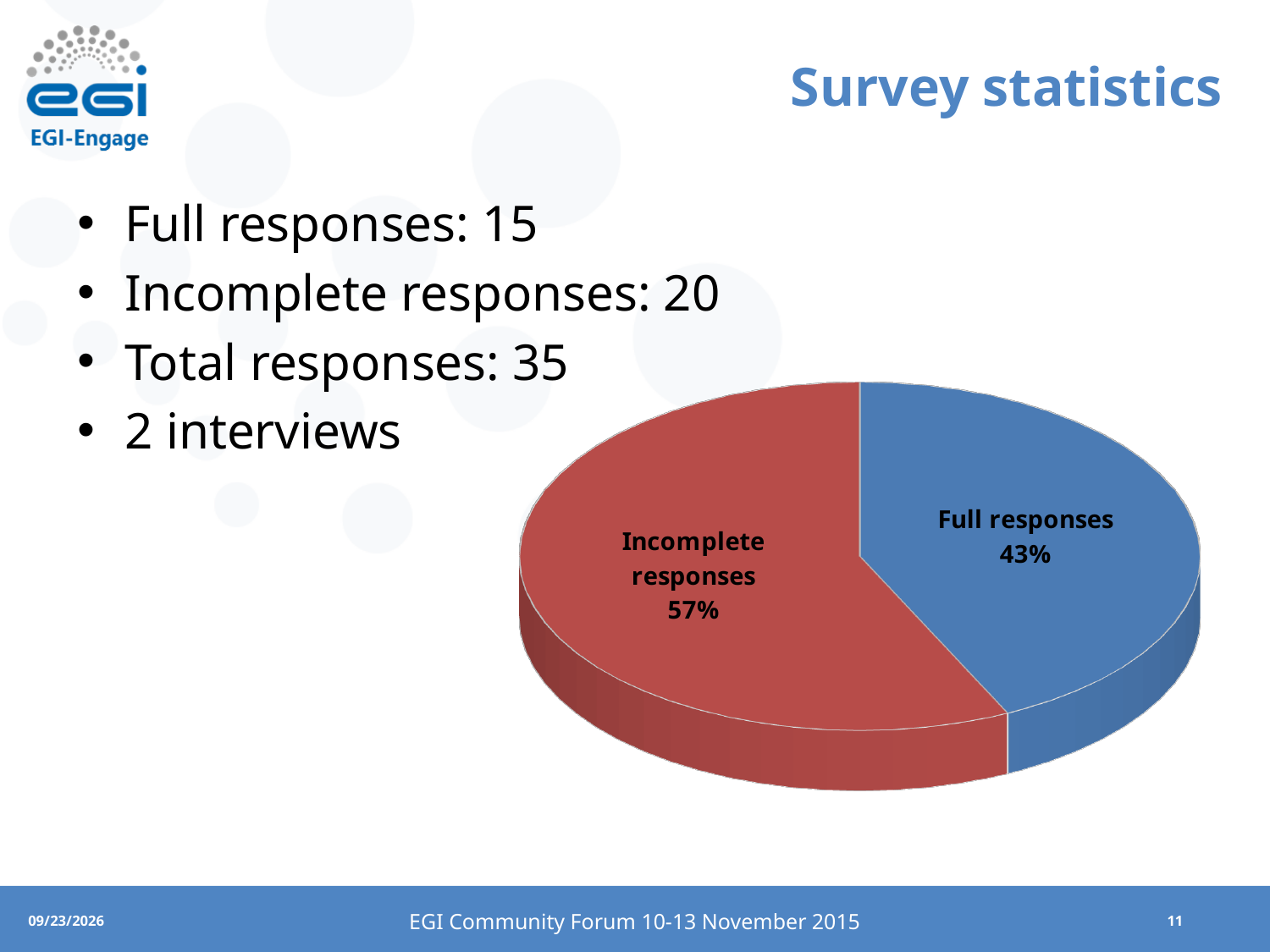
How many slices does the pie chart have? 2 Which slice is larger, Full responses or Incomplete responses? Incomplete responses Which slice of the pie chart is the smallest? Full responses What colour is the Full responses slice? Blue Which slice of the pie chart is the largest? Incomplete responses What colour is the Incomplete responses slice? Red Is the share for Full responses greater or less than 50%? less What is the difference in percentage points between the Incomplete responses slice and the Full responses slice? 14% What share of the pie is labelled Full responses? 43% What share of the pie is labelled Incomplete responses? 57% What kind of chart is shown on the slide? Pie chart